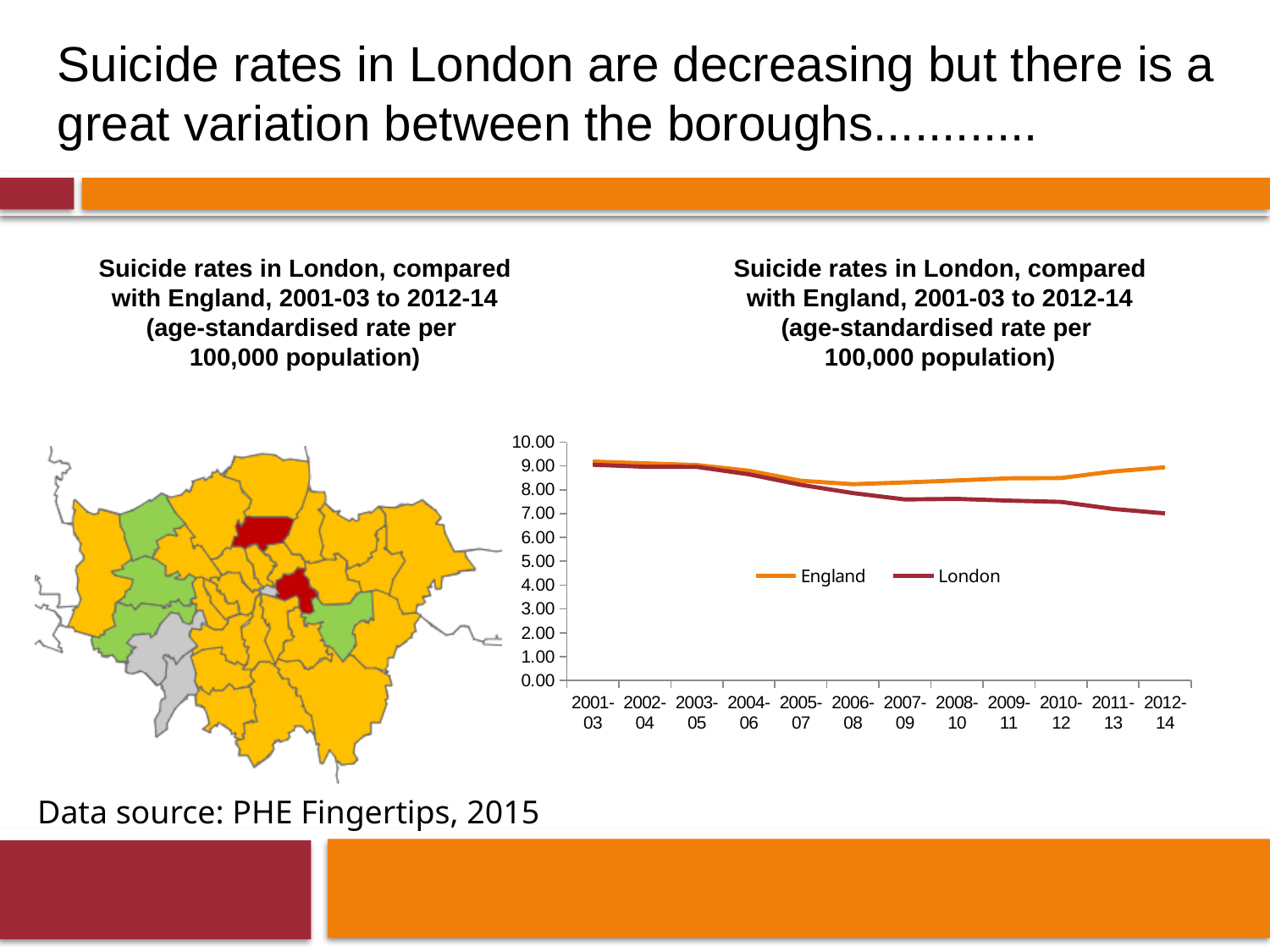
In the line chart on the right, how many time periods are shown on the x axis? 12 In the line chart on the right, is the value for London in 2001-03 greater or less than 8.00? greater In the line chart on the right, what is the first period shown on the x axis? 2001-03 In the line chart on the right, in which period is the London value lowest? 2012-14 In the line chart on the right, is the value for England in 2012-14 greater or less than 8.00? greater What kind of chart is the chart on the right of the slide? line chart In the line chart on the right, is the value for London in 2007-09 greater or less than 7.00? greater In the line chart on the right, which series is drawn in orange? England In the line chart on the right, how many series does the legend list? 2 In the line chart on the right, which series has the higher value in 2012-14, England or London? England In the line chart on the right, does the London line rise or fall from 2001-03 to 2012-14? fall